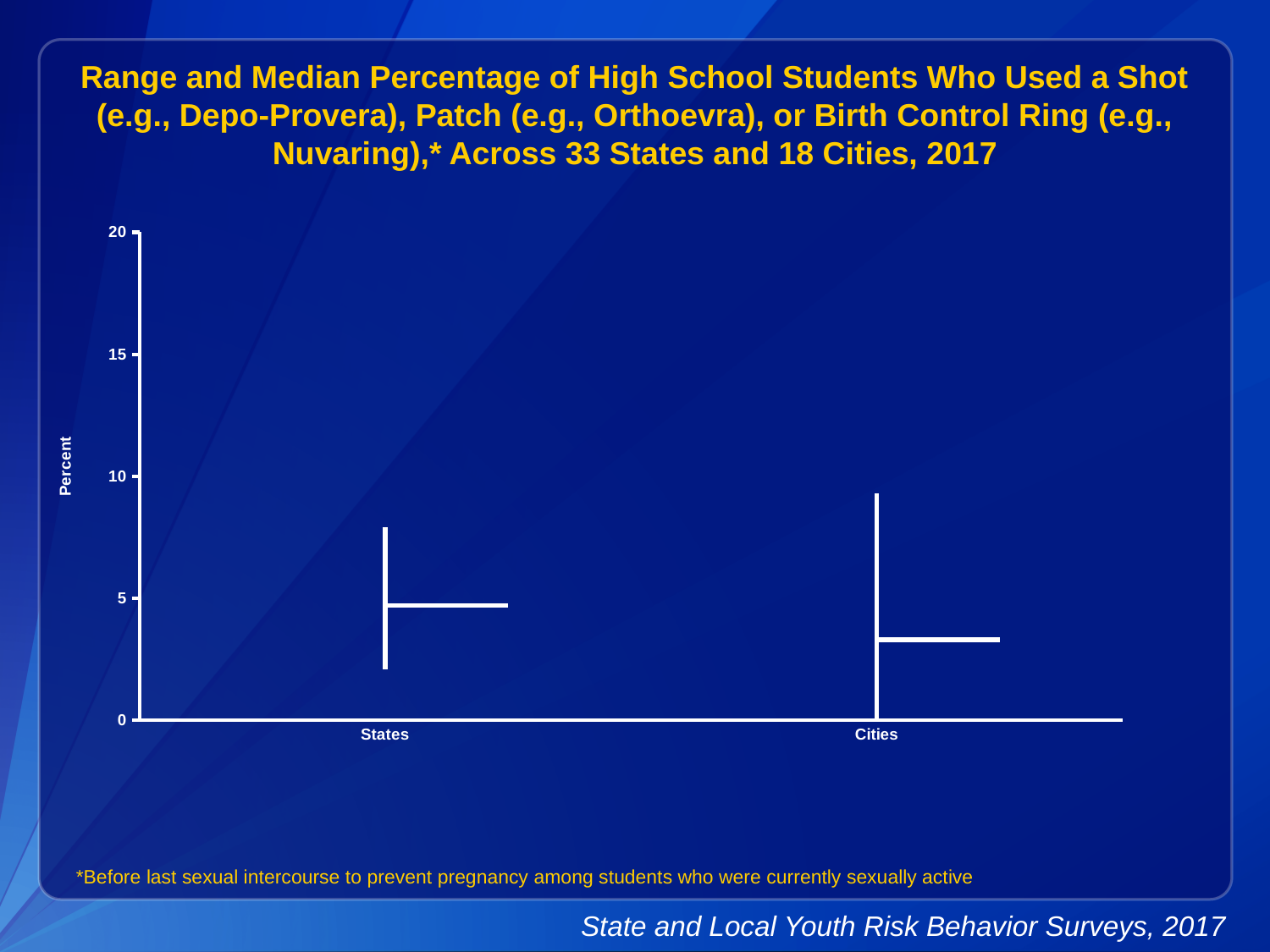
Is the median value for Cities greater or less than 5? less Which category has the higher median value, States or Cities? States What is the label on the y axis of the chart? Percent Is the top of the range for Cities greater or less than 5? greater What are the two categories shown on the x axis? States and Cities What is the highest value shown on the y axis? 20 Is the top of the range for States greater or less than 10? less How many categories are shown on the x axis of the chart? 2 Which category has the higher top of its range, States or Cities? Cities Which category has the wider range, States or Cities? Cities